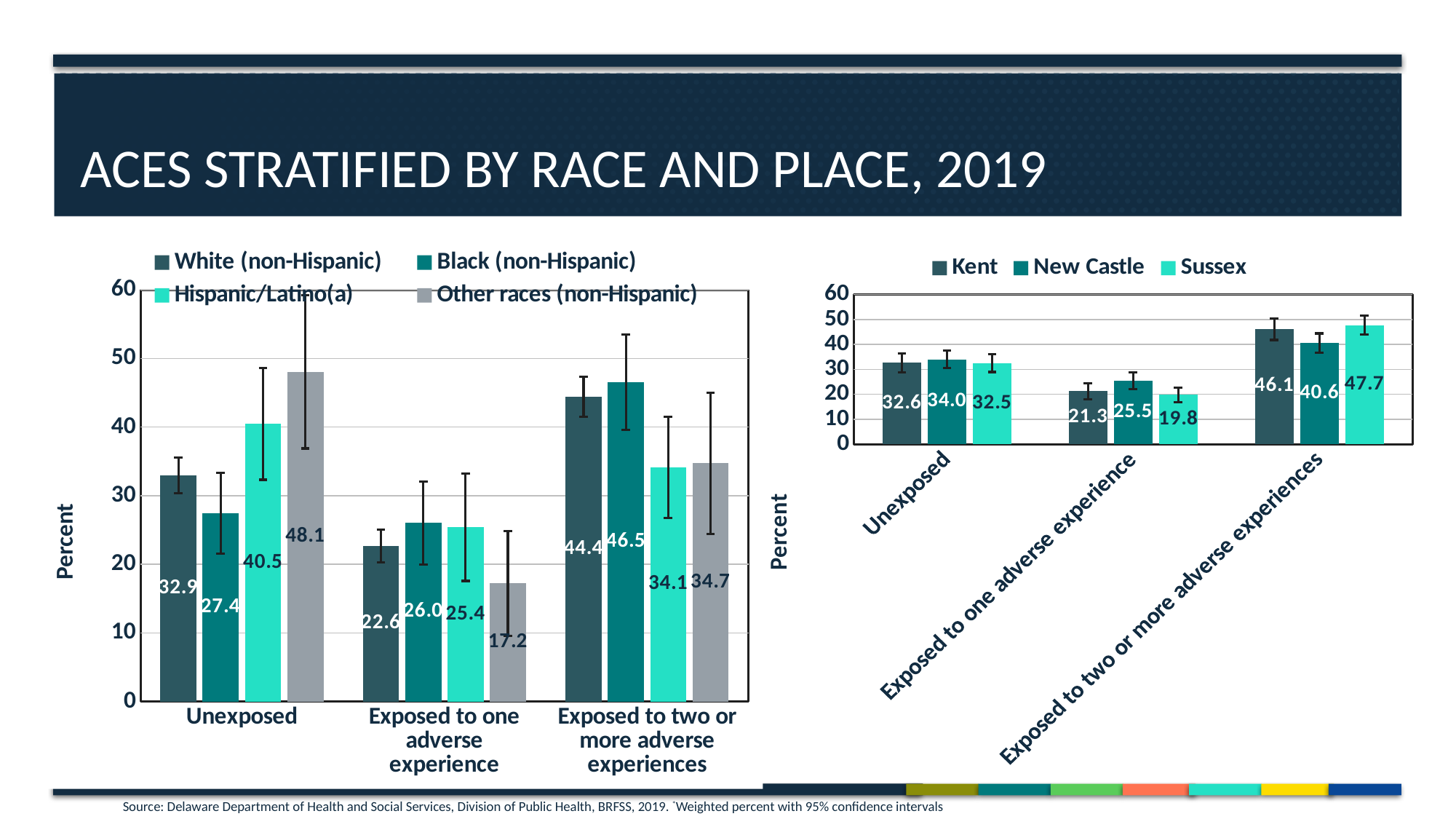
In the left chart, what is the difference between the Hispanic/Latino(a) and Black (non-Hispanic) values in the Unexposed category? 13.1 In the right chart, which county has the highest value in the Exposed to two or more adverse experiences category? Sussex In the right chart, what is the value for Sussex in the Exposed to two or more adverse experiences category? 47.7 In the left chart, how many series does the legend list? 4 In the left chart, what is the value for White (non-Hispanic) in the Exposed to two or more adverse experiences category? 44.4 In the left chart, which series has the lowest value in the Exposed to one adverse experience category? Other races (non-Hispanic) In the right chart, is the value for Kent in the Exposed to one adverse experience category larger or smaller than the value for New Castle in the same category? Smaller In the right chart, how many categories are shown on the x axis? 3 In the right chart, what is the value for New Castle in the Exposed to one adverse experience category? 25.5 In the right chart, what is the difference between the Sussex and New Castle values in the Exposed to two or more adverse experiences category? 7.1 What kind of chart is the left chart? Bar chart In the left chart, what is the value for Other races (non-Hispanic) in the Unexposed category? 48.1